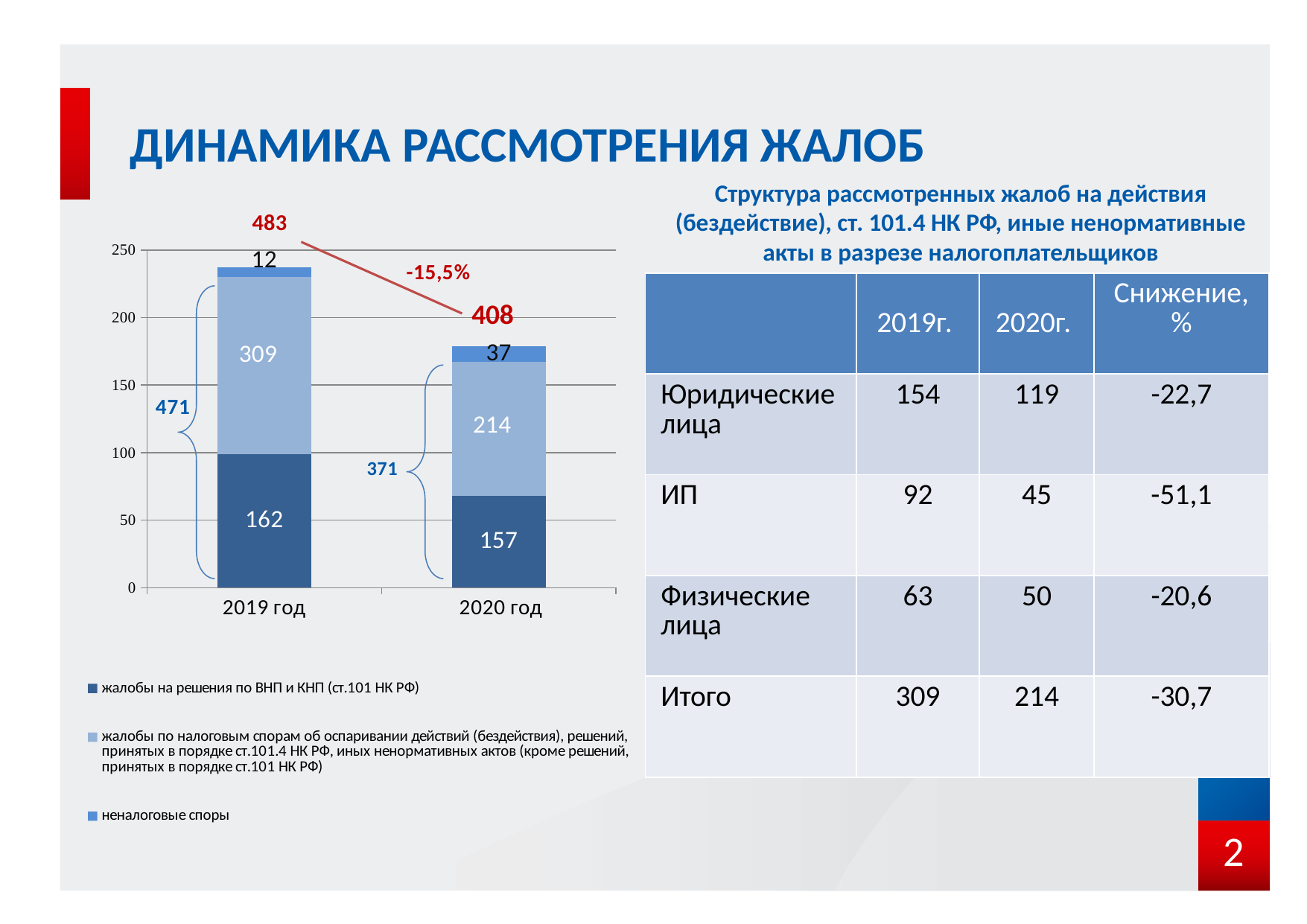
What type of chart is shown on the left of the slide? stacked bar chart In the bar chart, what is the value of 'неналоговые споры' for 2019 год? 12 What percentage change between the 2019 and 2020 totals is annotated on the bar chart? -15,5% What is the total of the stacked bar for 2020 год as labelled on the chart? 408 What is the total of the stacked bar for 2019 год as labelled on the chart? 483 How many categories (years) are shown on the x axis of the bar chart? 2 In the bar chart, what is the value of 'неналоговые споры' for 2020 год? 37 In the bar chart, what is the value of 'жалобы на решения по ВНП и КНП (ст.101 НК РФ)' for 2020 год? 157 By how much did the middle segment (complaints under ст.101.4 НК РФ) decrease from 2019 год to 2020 год in the bar chart? 95 In the bar chart, what is the value of 'жалобы на решения по ВНП и КНП (ст.101 НК РФ)' for 2019 год? 162 Which year has the larger value for 'неналоговые споры' in the bar chart, 2019 год or 2020 год? 2020 год How many series does the legend of the bar chart list? 3